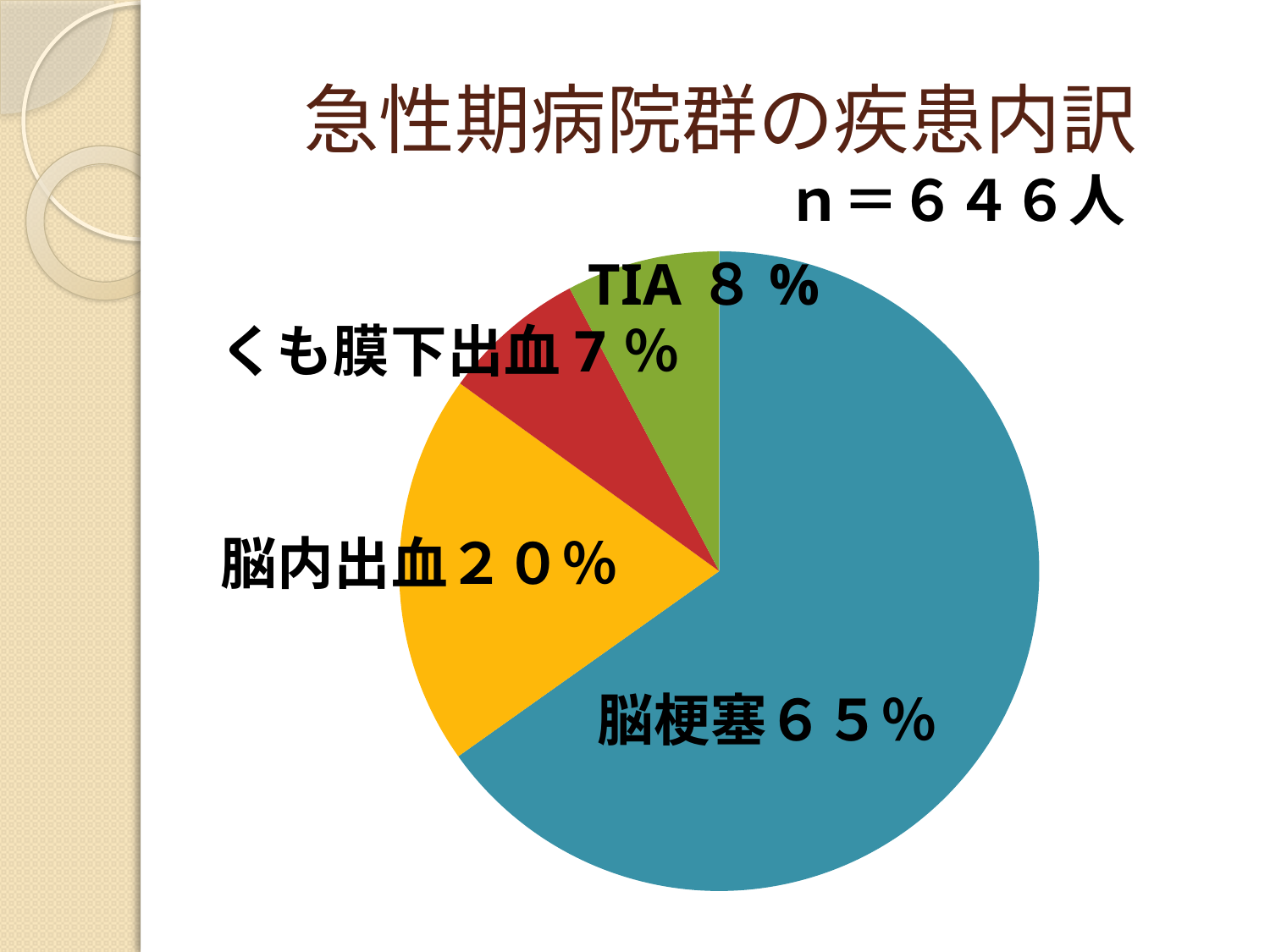
What is the difference in percentage points between 脳梗塞 and 脳内出血? 45 Which is larger, the share for TIA or the share for くも膜下出血? TIA What share of the pie does TIA account for? ８％ What share of the pie does くも膜下出血 account for? ７％ What is the sample size (n) shown on the slide? ６４６人 Which category has the smallest slice of the pie? くも膜下出血 How many slices does the pie chart have? 4 What share of the pie does 脳梗塞 account for? ６５％ What is the title of the chart? 急性期病院群の疾患内訳 What kind of chart is shown on the slide? pie chart Which category has the largest slice of the pie? 脳梗塞